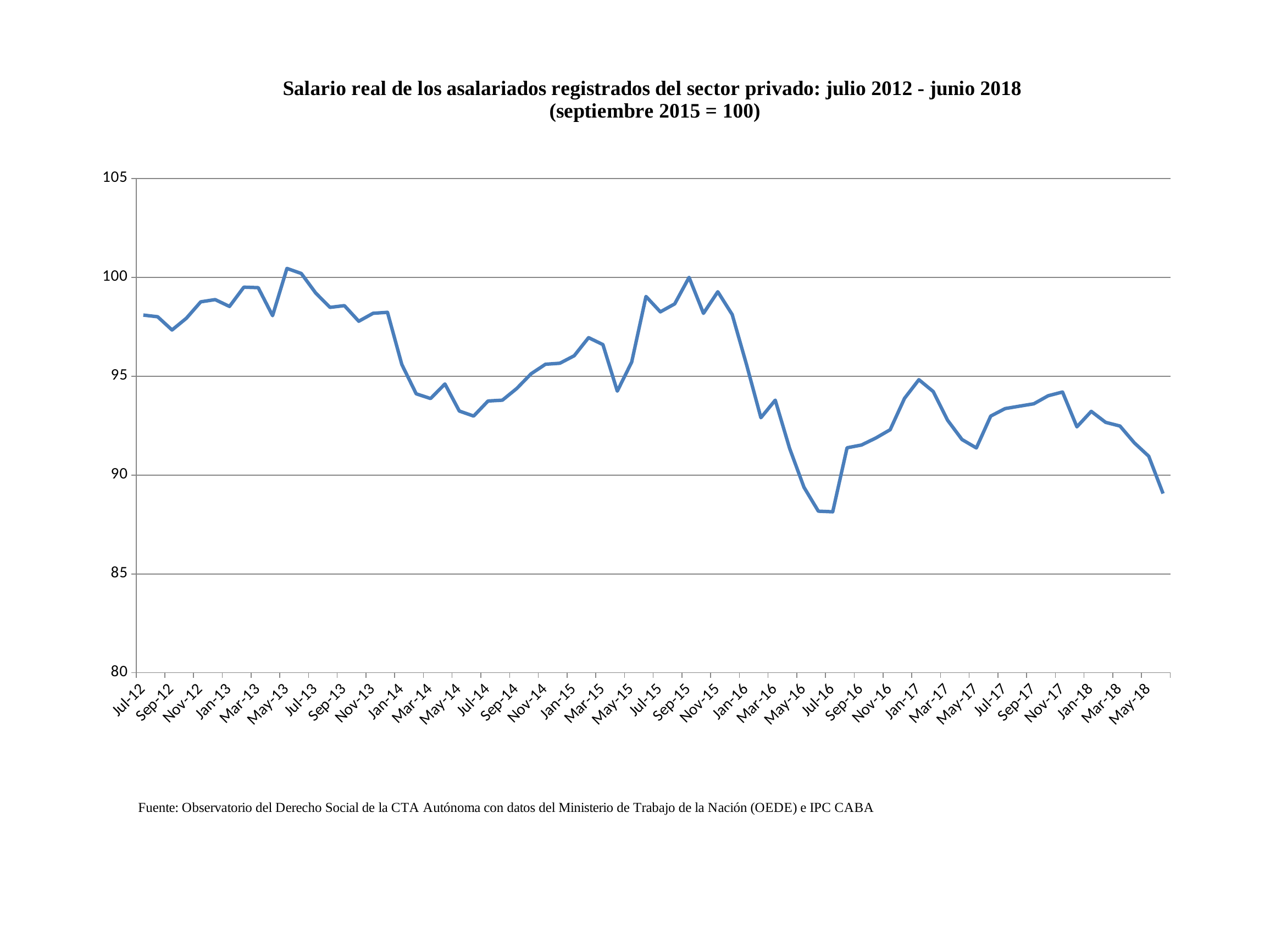
Is the value for Jul-16 greater or less than 90? less Is the value for Jan-14 greater or less than 95? greater Which is larger, the value for Sep-15 or the value for Mar-16? Sep-15 Which month is used as the base period (= 100) according to the chart title? septiembre 2015 Is the value for Mar-16 greater or less than 95? less Overall, does the real wage index rise or fall from Jul-12 to the end of the series in 2018? fall Which is larger, the value for Jan-14 or the value for Jul-16? Jan-14 What kind of chart is shown on the slide? line chart What is the value of the index for Sep-15, the base period? 100